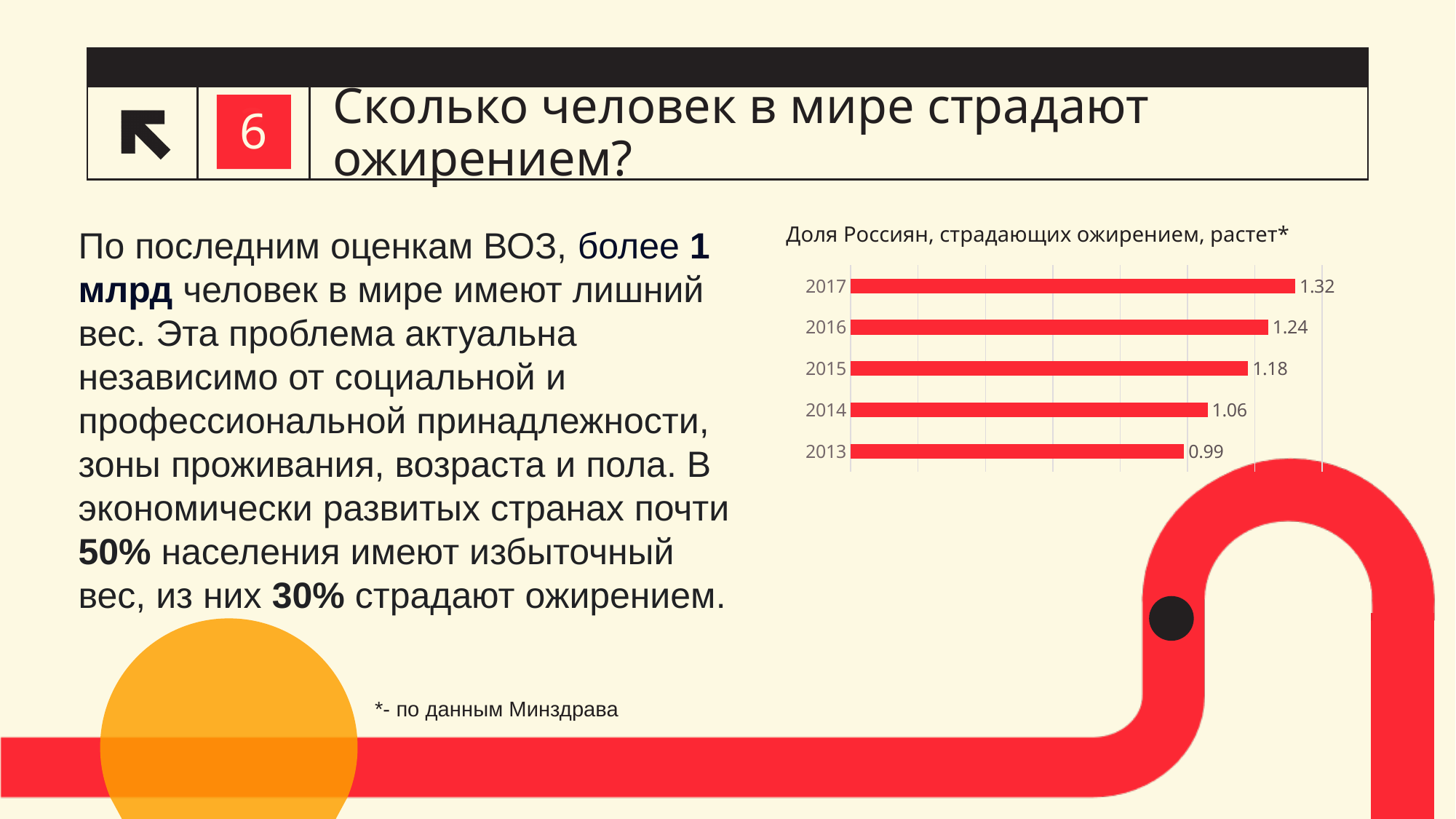
What is the value for 2017? 1.32 What is the difference between the values for 2017 and 2013? 0.33 What is the title of the chart? Доля Россиян, страдающих ожирением, растет* What is the value for 2013? 0.99 What is the difference between the values for 2016 and 2014? 0.18 What is the value for 2015? 1.18 Which year has the lowest value? 2013 Which year has the highest value? 2017 What kind of chart is shown on the slide? bar chart Do the values rise or fall from 2013 to 2017? rise Which is larger, the value for 2014 or the value for 2015? 2015 How many years are shown in the chart? 5